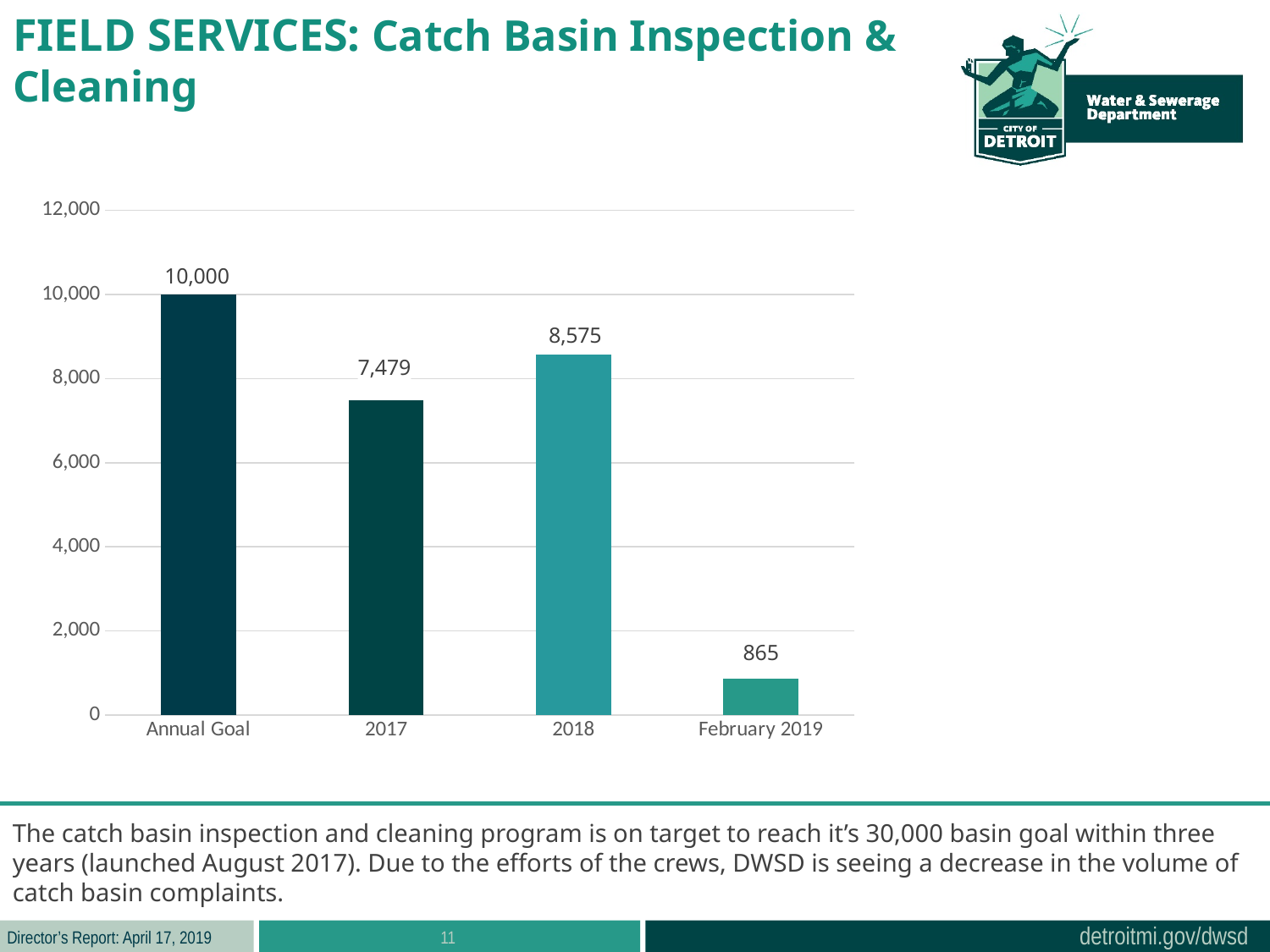
Which category has the lowest value? February 2019 What is the difference between the values for 2018 and 2017? 1,096 What kind of chart is shown on the slide? bar chart What is the difference between the Annual Goal and the value for 2018? 1,425 What is the value for 2018? 8,575 Is the value for 2017 greater or less than 8,000? less Which is larger, the value for 2017 or the value for 2018? 2018 What is the value for February 2019? 865 What is the value for 2017? 7,479 What is the value for Annual Goal? 10,000 Which category has the highest value? Annual Goal How many categories are shown on the x axis? 4